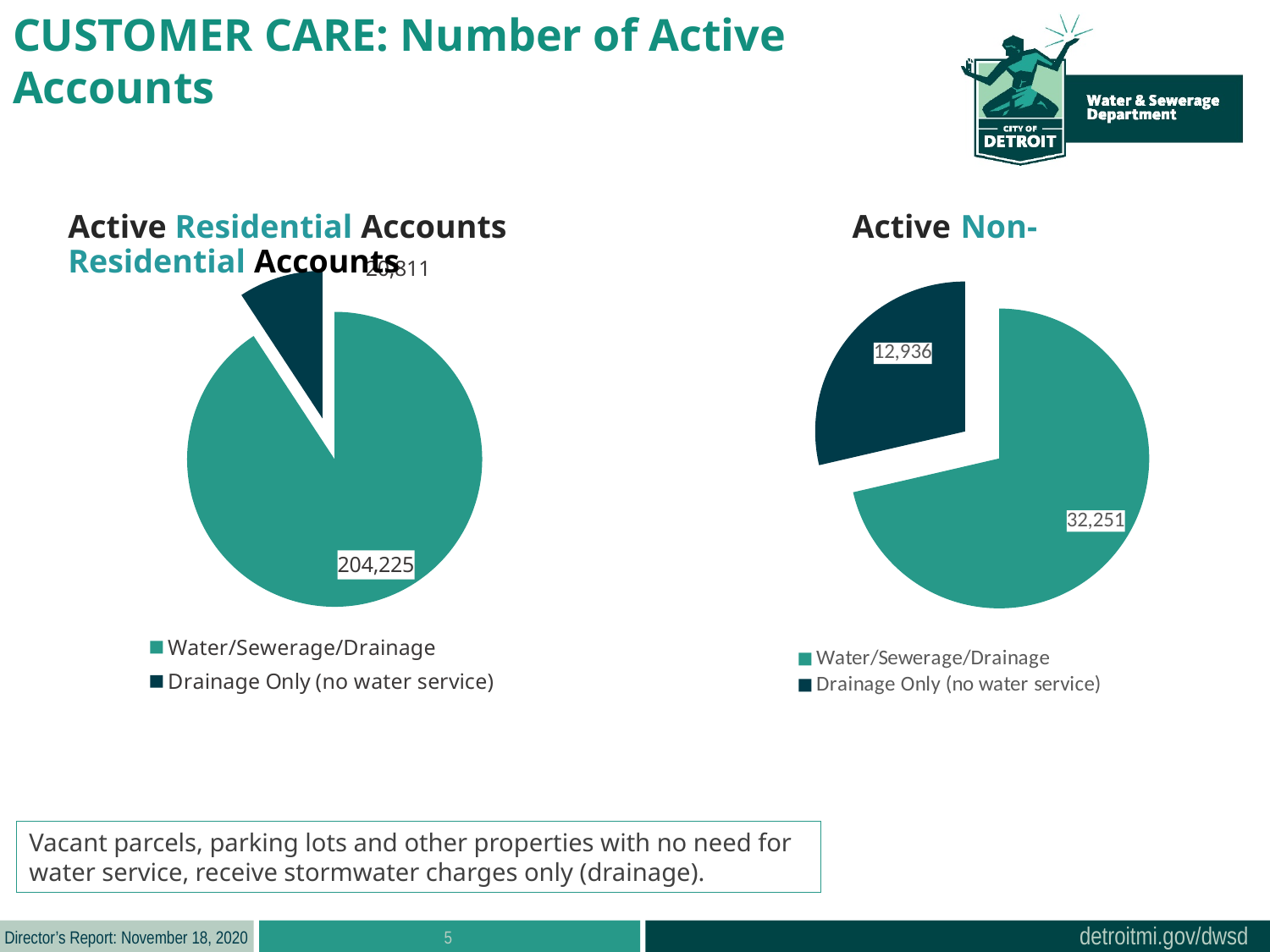
In the Active Residential Accounts chart, what is the value for Water/Sewerage/Drainage? 204,225 In the Active Non-Residential Accounts chart, what is the value for Water/Sewerage/Drainage? 32,251 In the Active Non-Residential Accounts chart, which category has the largest slice? Water/Sewerage/Drainage In the Active Residential Accounts chart, which category has the smallest slice? Drainage Only (no water service) What kind of chart is the Active Non-Residential Accounts chart? Pie chart In the Active Non-Residential Accounts chart, which legend entry is shown in the dark navy colour? Drainage Only (no water service) In the Active Non-Residential Accounts chart, what is the difference between Water/Sewerage/Drainage and Drainage Only (no water service)? 19,315 Which is larger: Water/Sewerage/Drainage in the Active Residential Accounts chart or Water/Sewerage/Drainage in the Active Non-Residential Accounts chart? Active Residential Accounts How many entries does the legend of the Active Non-Residential Accounts chart list? 2 In the Active Non-Residential Accounts chart, what is the total of the two slices? 45,187 How many slices does the Active Residential Accounts pie chart have? 2 In the Active Non-Residential Accounts chart, what is the value for Drainage Only (no water service)? 12,936